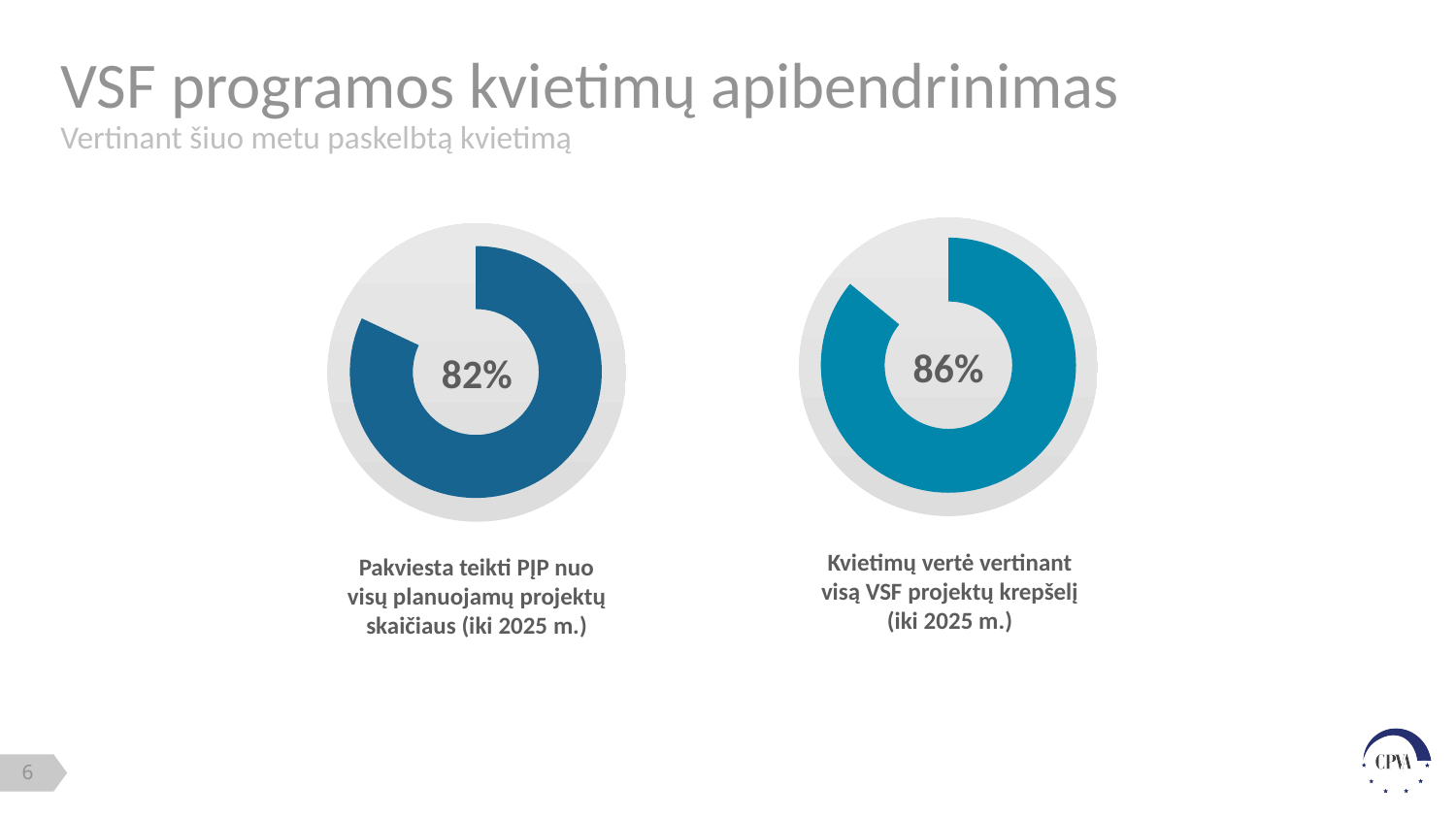
In the left donut chart, what share of the ring is filled with the dark blue colour? 82% What is the caption below the left donut chart? Pakviesta teikti PĮP nuo visų planuojamų projektų skaičiaus (iki 2025 m.) Is the value in the left donut chart greater or less than 80%? greater Which chart shows the higher percentage, the left one (Pakviesta teikti PĮP) or the right one (Kvietimų vertė)? the right one (86%) What is the title of the slide containing the two donut charts? VSF programos kvietimų apibendrinimas What is the difference in percentage points between the right chart's value (86%) and the left chart's value (82%)? 4 percentage points How many donut charts are on the slide? 2 In the right donut chart, what share of the ring is left unfilled (grey)? 14% What type of chart is used on this slide? donut (pie) chart What percentage is shown in the centre of the left donut chart? 82% Is the value in the right donut chart greater or less than 90%? less What percentage is shown in the centre of the right donut chart? 86%